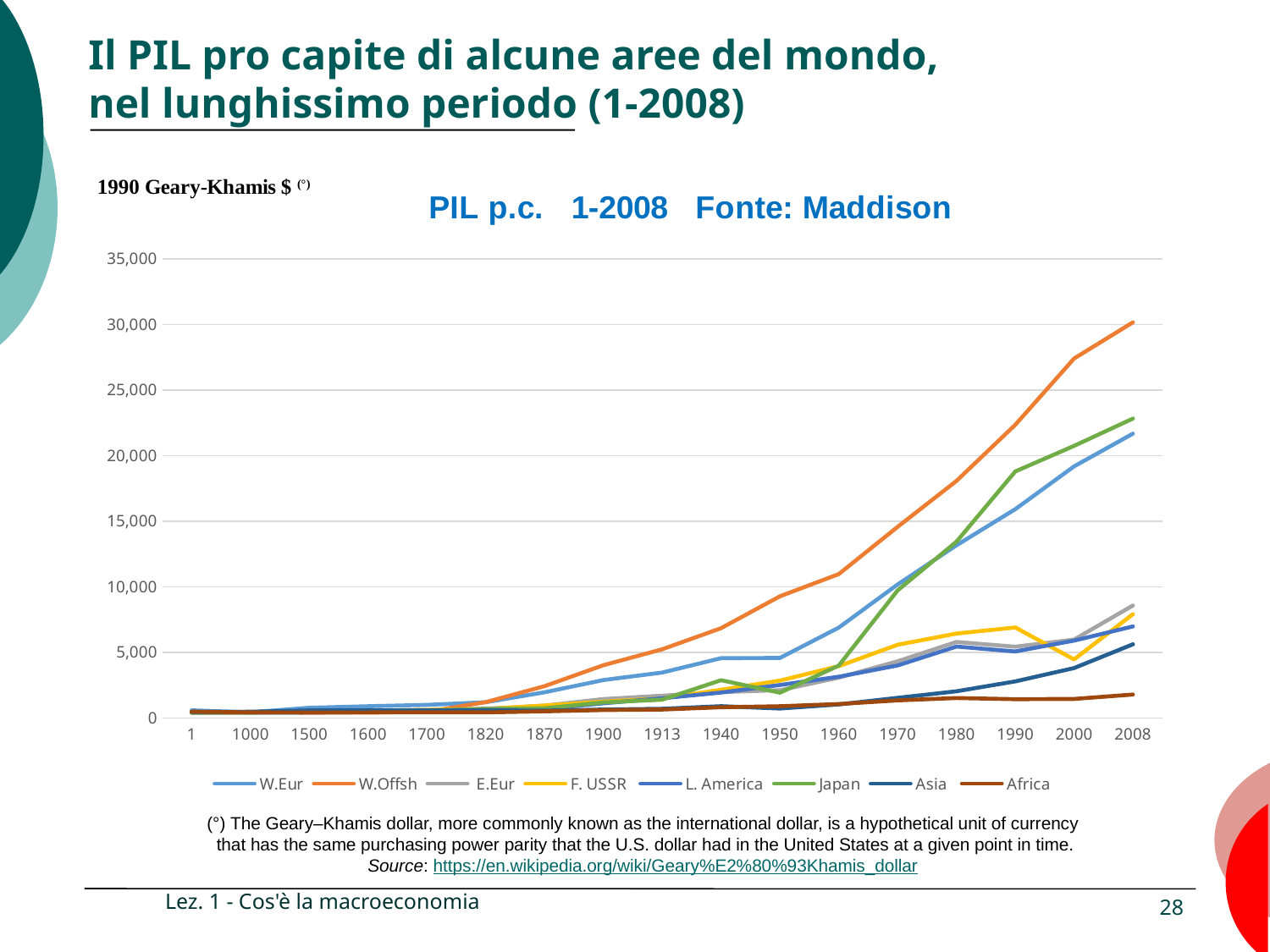
Is the value for Africa in 2008 greater or less than 5,000? less In 1960, which is larger: the value for W.Eur or the value for Japan? W.Eur Is the value for W.Offsh in 1980 greater or less than 15,000? greater What kind of chart is shown on the slide? line chart Does the W.Offsh series rise or fall from 1820 to 2008? rise Is the value for W.Offsh in 2008 greater or less than 25,000? greater Which series has the lowest value in 2008? Africa Which series has the highest value in 2008? W.Offsh How many series does the legend list? 8 How many points are there along the x axis? 17 What is the title of the chart? PIL p.c. 1-2008 Fonte: Maddison